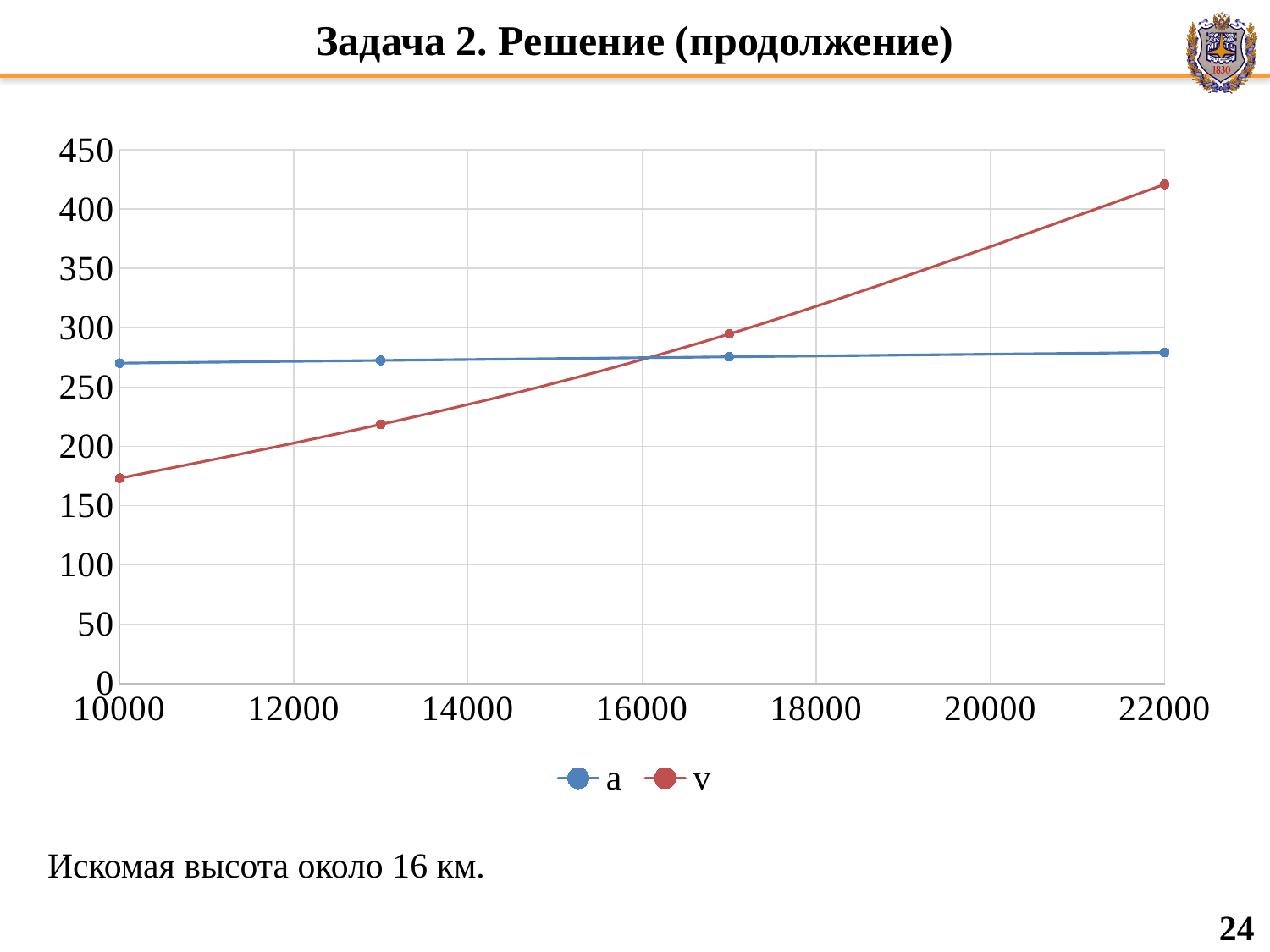
At x = 10000, which series has the larger value, a or v? a How many data points are plotted for series v? 4 Is the value of series v at x = 10000 greater or less than 200? less At x = 22000, which series has the larger value, a or v? v Do the values of series v rise or fall as the x value increases from 10000 to 22000? rise At which x value does series v have its lowest value? 10000 What are the names of the series in the legend? a and v What kind of chart is shown on the slide? line chart Is the value of series v at x = 22000 greater or less than 400? greater What colour is the line for series v? red At which x value does series v reach its highest value? 22000 How many series does the legend list? 2